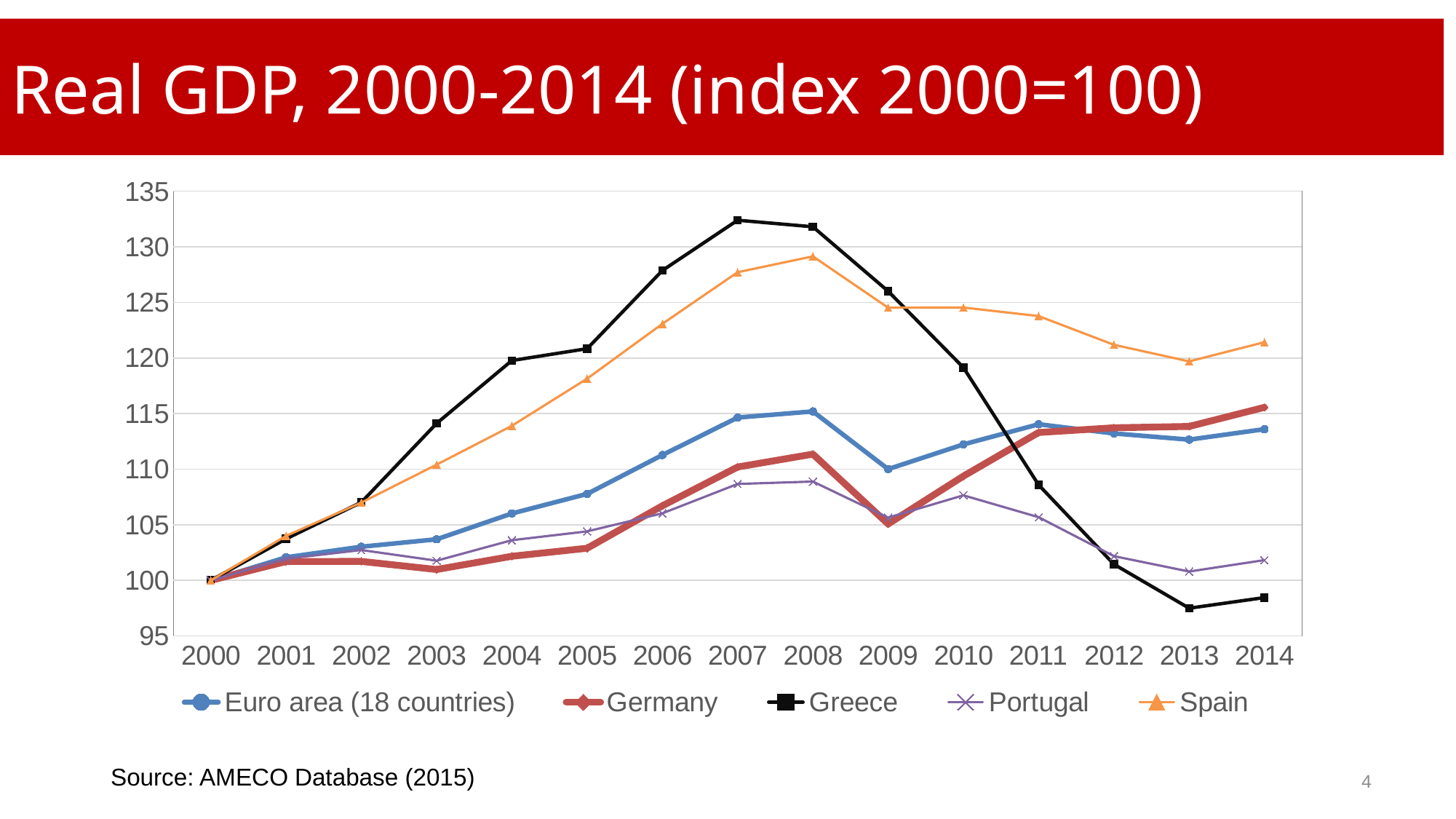
How many series does the legend list? 5 What is the value for Greece in 2000? 100 Is the value for Greece in 2013 greater or less than 100? less Is the value for Spain in 2008 greater or less than 125? greater Which series has the highest value in 2007? Greece What source is cited below the chart? AMECO Database (2015) Is the value for Greece in 2007 greater or less than 130? greater Does the value for Greece rise or fall from 2008 to 2013? fall Which series has the lowest value in 2014? Greece Which series has the highest value in 2014? Spain What kind of chart is shown on the slide? line chart How many years are plotted along the x axis? 15